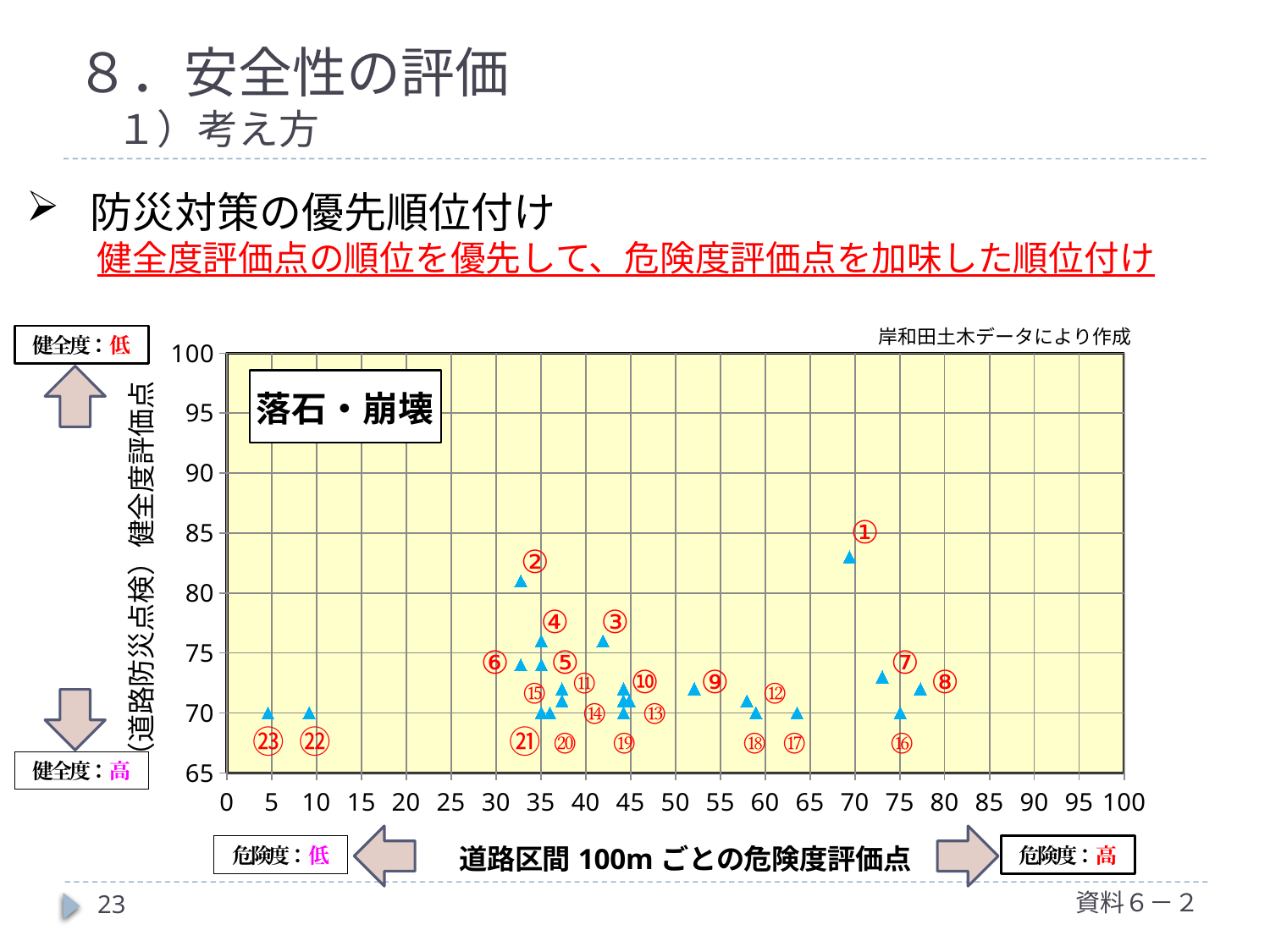
Which numbered point has the highest 危険度評価点 (x value)? ⑧ Which numbered point has the lowest 危険度評価点 (x value)? ㉓ How many numbered data points are plotted on the chart? 23 Which point has a higher 健全度評価点 (y value), point ① or point ③? ① Is the 危険度評価点 (x value) of point ⑧ greater or less than 75? greater What kind of chart is shown on the slide? scatter chart What is the label of the x axis of the chart? 道路区間100mごとの危険度評価点 Is the 健全度評価点 (y value) of point ① greater or less than 80? greater What is the title shown in the box inside the chart? 落石・崩壊 Which point has a higher 危険度評価点 (x value), point ⑥ or point ⑧? ⑧ Is the 危険度評価点 (x value) of point ㉓ greater or less than 10? less Which numbered point has the highest 健全度評価点 (y value)? ①